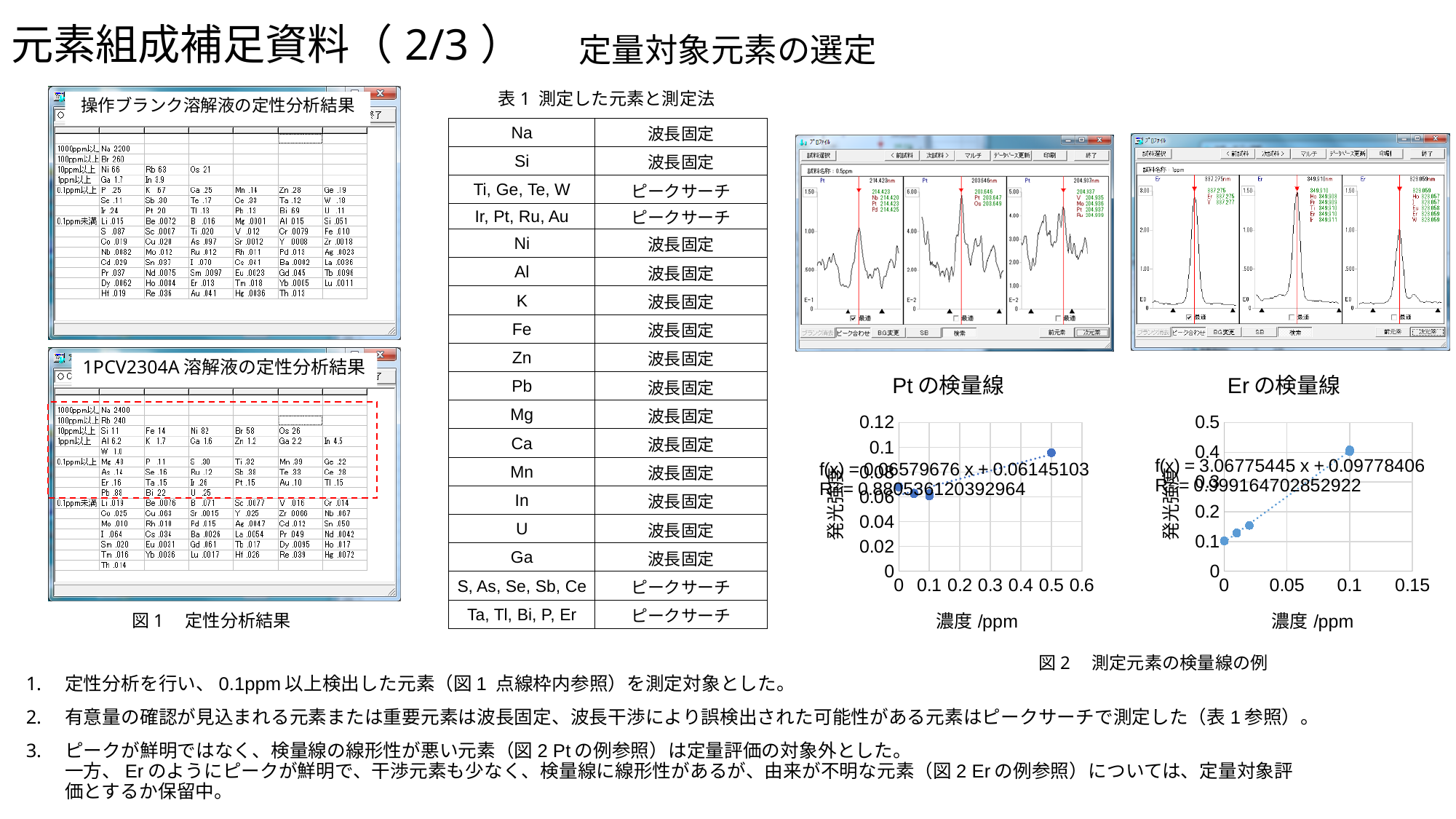
In the Pt の検量線 chart, is the 発光強度 value at 濃度 0.5 ppm greater or less than 0.08? greater What is the R² value printed on the Pt の検量線 chart? 0.880536120392964 In the Er の検量線 chart, which has the larger 発光強度 value: the point at 濃度 0.1 ppm or the point at 濃度 0 ppm? 0.1 ppm In the Pt の検量線 chart, which has the larger 発光強度 value: the point at 濃度 0.5 ppm or the point at 濃度 0.1 ppm? 0.5 ppm What is the trendline equation printed on the Er の検量線 chart? f(x) = 3.06775445 x + 0.09778406 What kind of chart is the Pt の検量線 chart? scatter chart In the Er の検量線 chart, do the plotted values rise or fall as 濃度 /ppm increases? rise What kind of chart is the Er の検量線 chart? scatter chart In the Er の検量線 chart, is the 発光強度 value at 濃度 0 ppm greater or less than 0.2? less In the Er の検量線 chart, is the 発光強度 value at 濃度 0.1 ppm greater or less than 0.3? greater